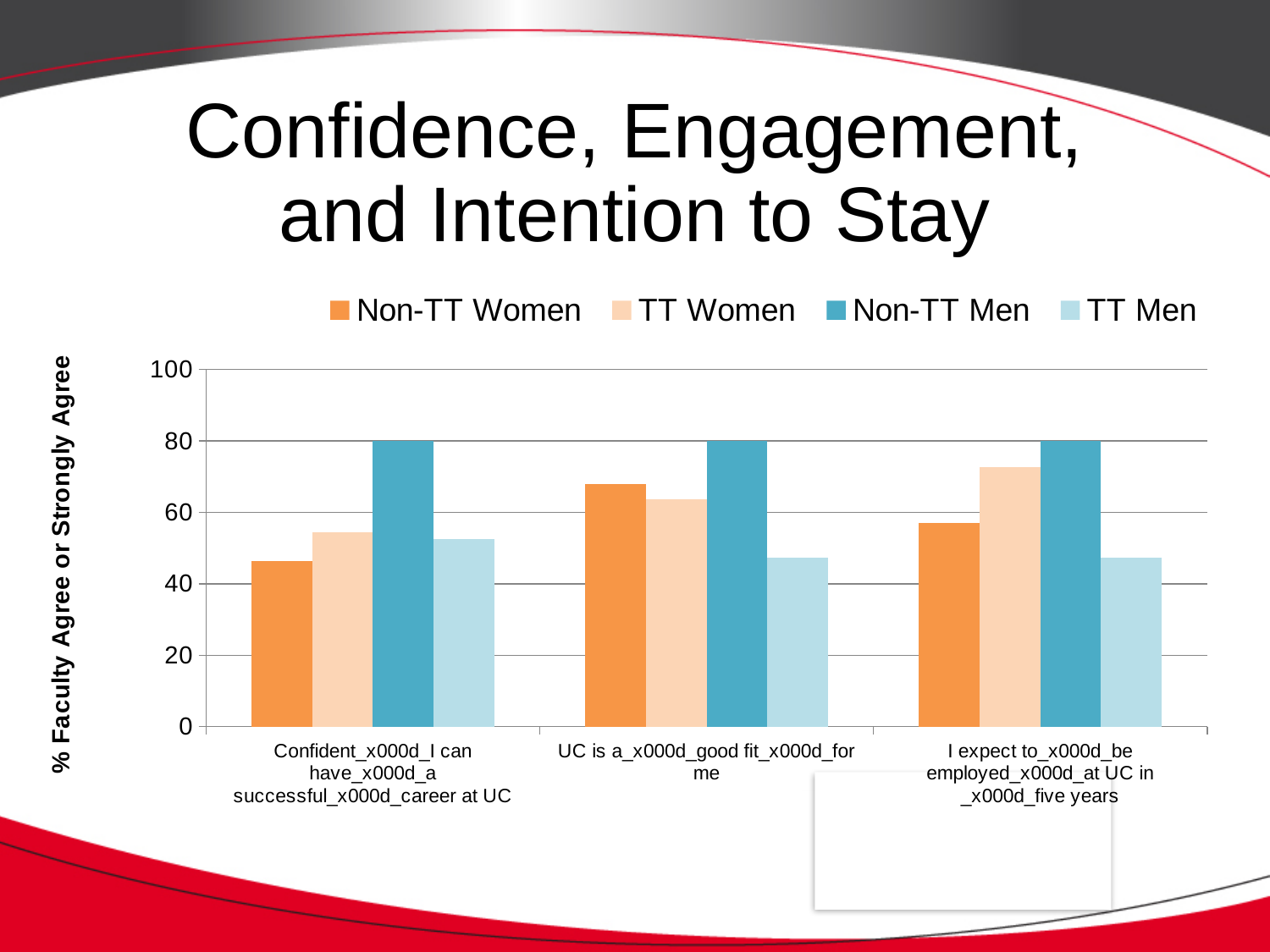
Which series is shown in the darkest blue colour in the legend? Non-TT Men How many categories are shown on the x axis? 3 Is the value for Non-TT Women in the category 'Confident I can have a successful career at UC' greater or less than 60? less Which series has the highest value for the category 'Confident I can have a successful career at UC'? Non-TT Men What is the label of the vertical axis? % Faculty Agree or Strongly Agree Which series has the lowest value for the category 'Confident I can have a successful career at UC'? Non-TT Women Is the value for TT Women in the category 'I expect to be employed at UC in five years' greater or less than 60? greater Which series has the lowest value for the category 'I expect to be employed at UC in five years'? TT Men Do the values for TT Women rise or fall across the three categories from left to right? rise How many series does the legend list? 4 Which is larger for the category 'I expect to be employed at UC in five years': the value for Non-TT Women or the value for TT Women? TT Women What kind of chart is shown on the slide? bar chart